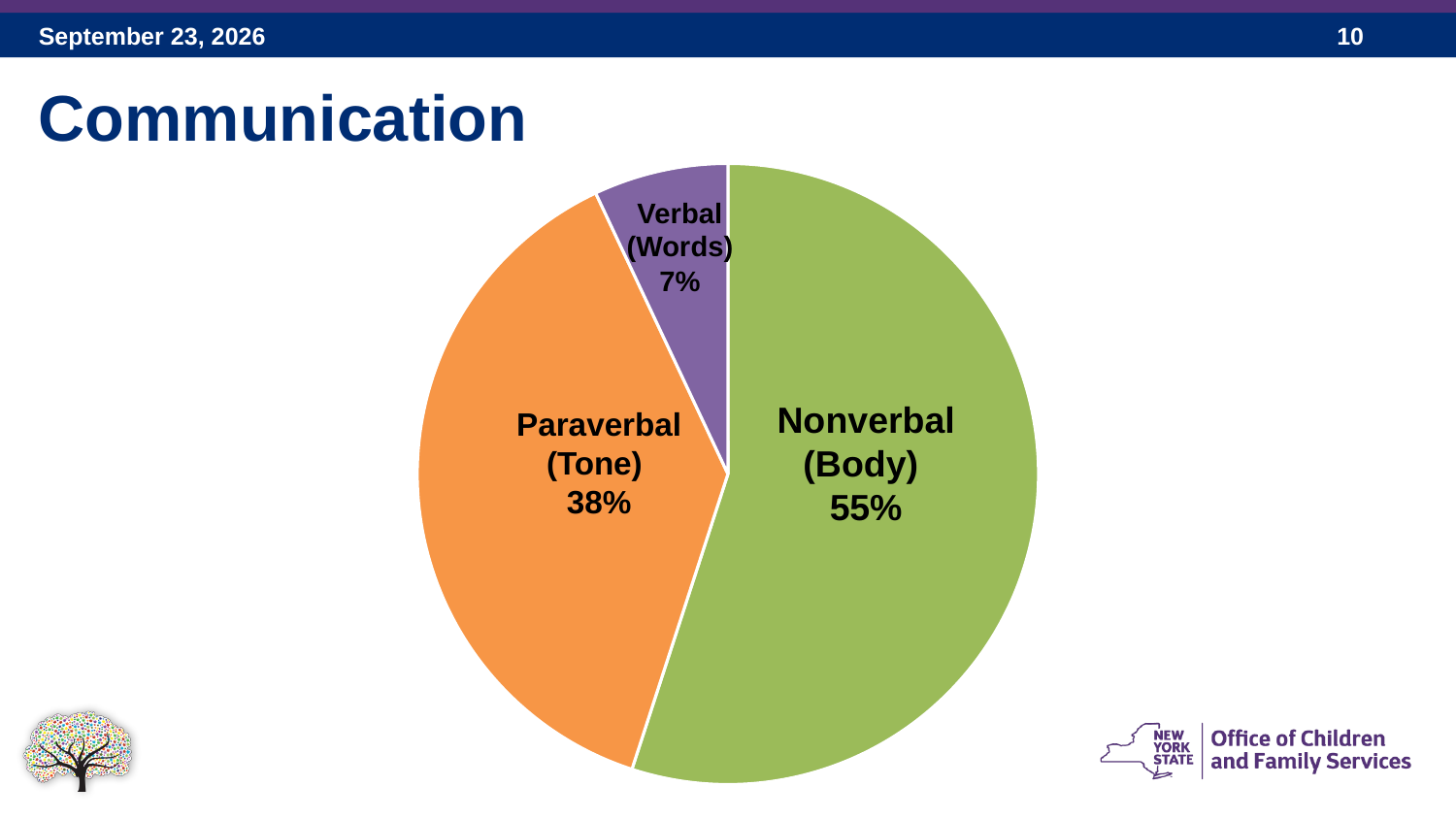
What is the difference between the Paraverbal (Tone) share and the Verbal (Words) share? 31% What colour is the Nonverbal (Body) slice? green Which slice of the pie is the smallest? Verbal (Words) Which slice of the pie is the largest? Nonverbal (Body) What share of the pie does Nonverbal (Body) represent? 55% What is the difference between the Nonverbal (Body) share and the Paraverbal (Tone) share? 17% What share of the pie does Paraverbal (Tone) represent? 38% Which is larger, the Paraverbal (Tone) slice or the Verbal (Words) slice? Paraverbal (Tone) How many slices does the pie chart have? 3 What kind of chart is shown on the slide? pie chart What share of the pie does Verbal (Words) represent? 7% What is the title of the slide containing the pie chart? Communication